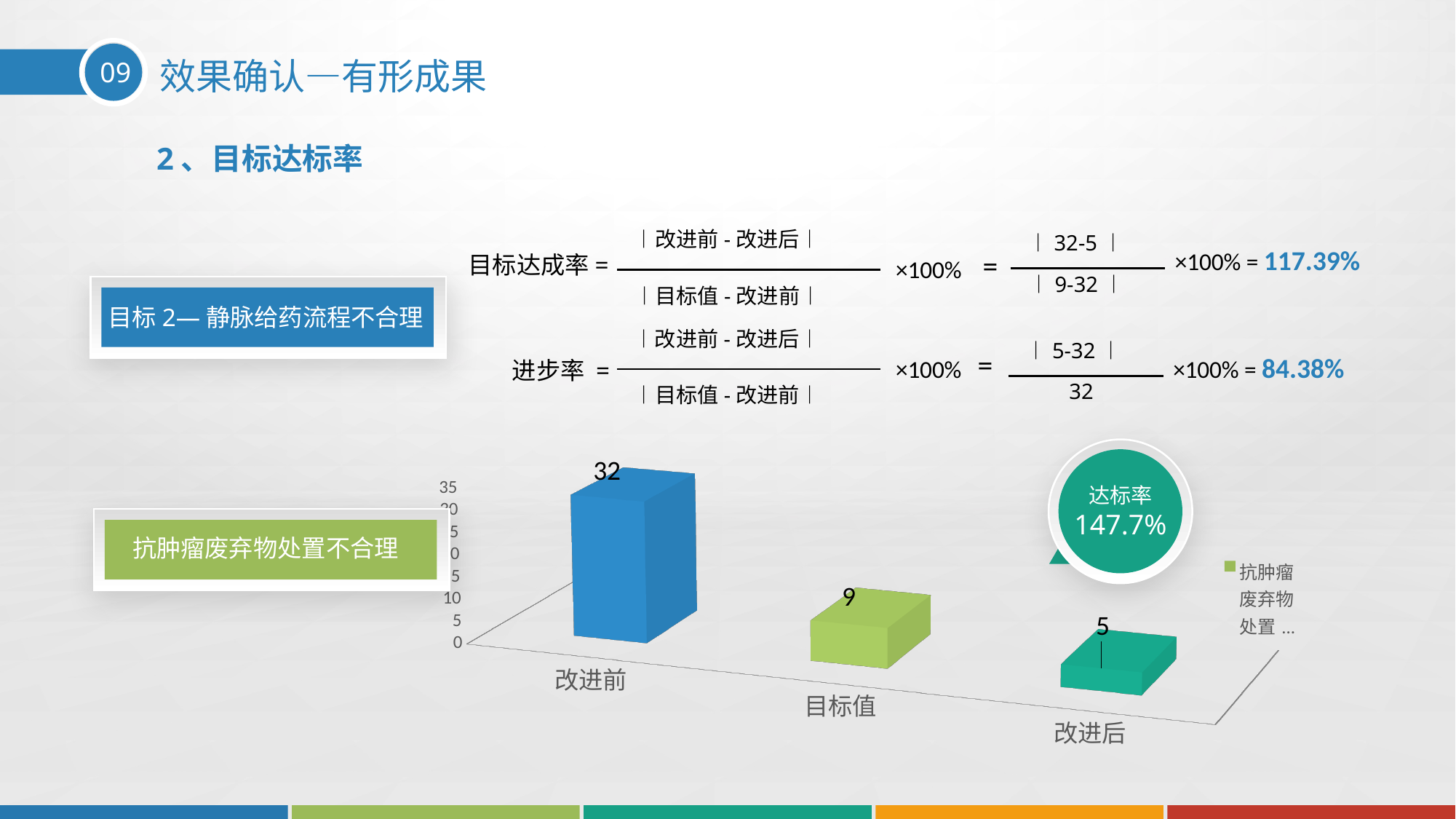
What is the difference between the values for 改进前 and 改进后 in the bar chart? 27 Which category has the lowest value in the bar chart? 改进后 What is the value for 目标值 in the bar chart? 9 Which category has the highest value in the bar chart? 改进前 Do the values in the bar chart rise or fall from 改进前 to 改进后? fall What is the value for 改进前 in the bar chart? 32 Is the value for 改进前 in the bar chart greater or less than 30? greater Which is larger in the bar chart, the value for 目标值 or the value for 改进后? 目标值 What is the value for 改进后 in the bar chart? 5 How many categories are shown on the x axis of the bar chart? 3 What kind of chart is shown on the slide? bar chart What is the difference between the values for 目标值 and 改进后 in the bar chart? 4